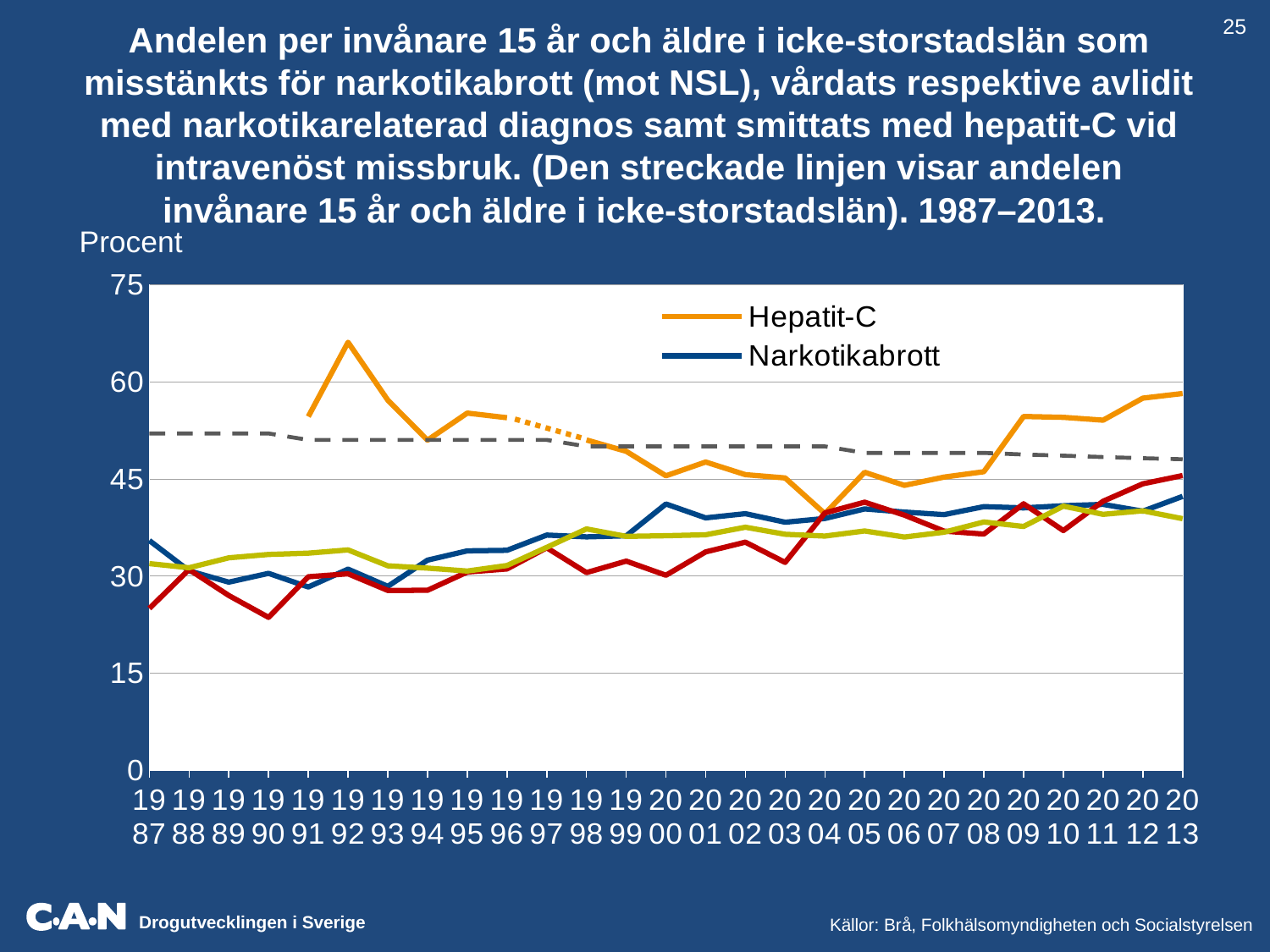
Is the Hepatit-C value for 1992 greater or less than 60? greater What colour is the Hepatit-C line in the legend? orange How many years are shown along the x axis? 27 In which year does the Hepatit-C line reach its lowest value? 2004 What is the label on the y axis? Procent Is the Narkotikabrott value for 2013 greater or less than 45? less Does the Hepatit-C line rise or fall between 1992 and 2004? fall Which is larger in 2013, the Hepatit-C value or the Narkotikabrott value? Hepatit-C What kind of chart is shown on the slide? line chart How many series does the legend list? 2 Is the Hepatit-C value for 1995 greater or less than 45? greater In which year does the Hepatit-C line reach its highest value? 1992